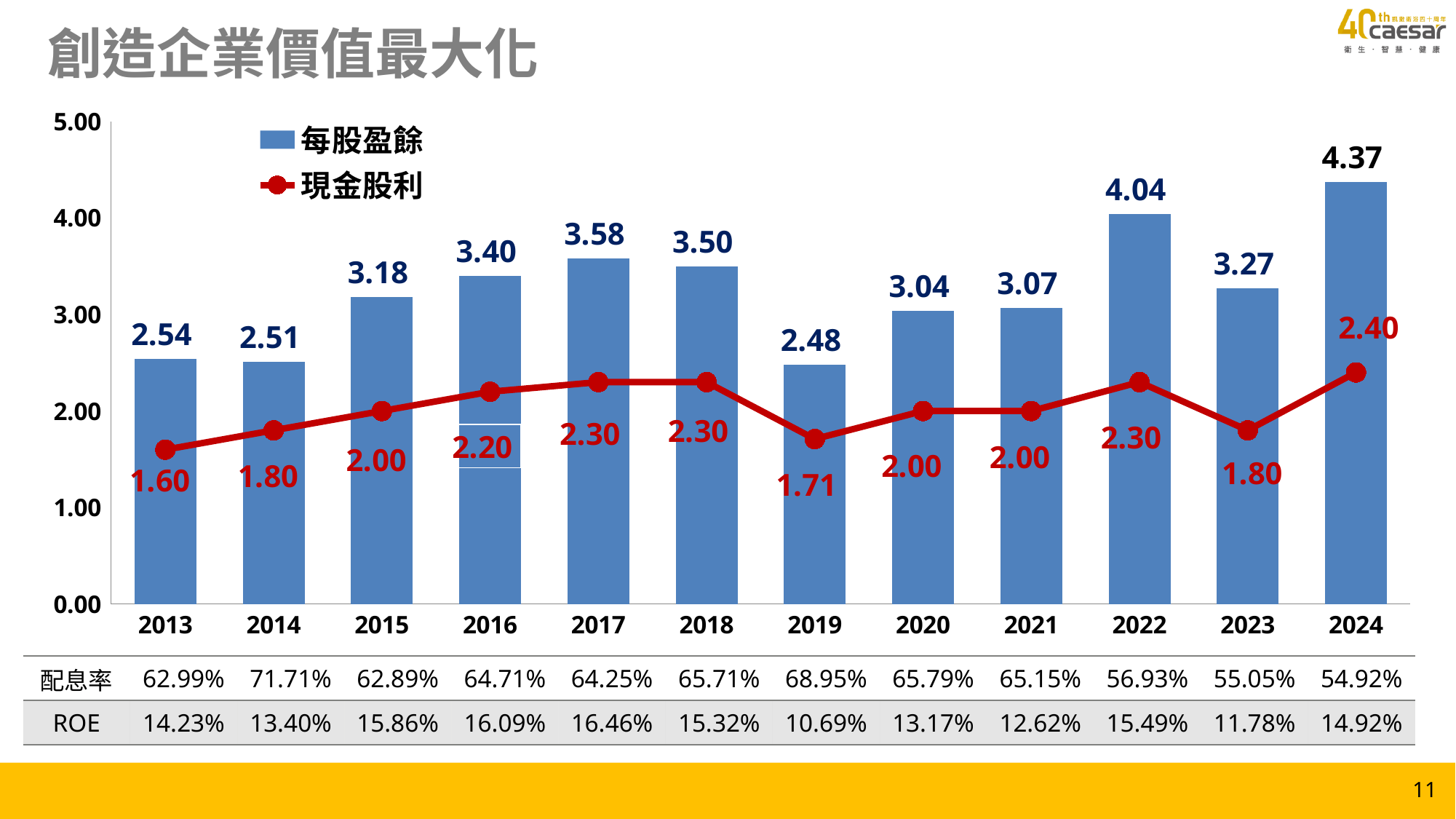
What is the 每股盈餘 (EPS) value for 2024? 4.37 Which is larger, the 每股盈餘 for 2017 or for 2018? 2017 What kind of chart is used to show 每股盈餘? bar chart Which year has the highest 每股盈餘 (EPS)? 2024 Is the 每股盈餘 value for 2019 greater or less than 3.00? less How many years are shown on the x axis of the chart? 12 What colour is the 現金股利 line in the chart? red What is the difference between the 每股盈餘 values for 2022 and 2023? 0.77 What is the 現金股利 (cash dividend) value for 2019? 1.71 Which year has the lowest 現金股利 (cash dividend)? 2013 Does the 每股盈餘 value rise or fall from 2013 to 2017? rise How many series does the chart legend list? 2